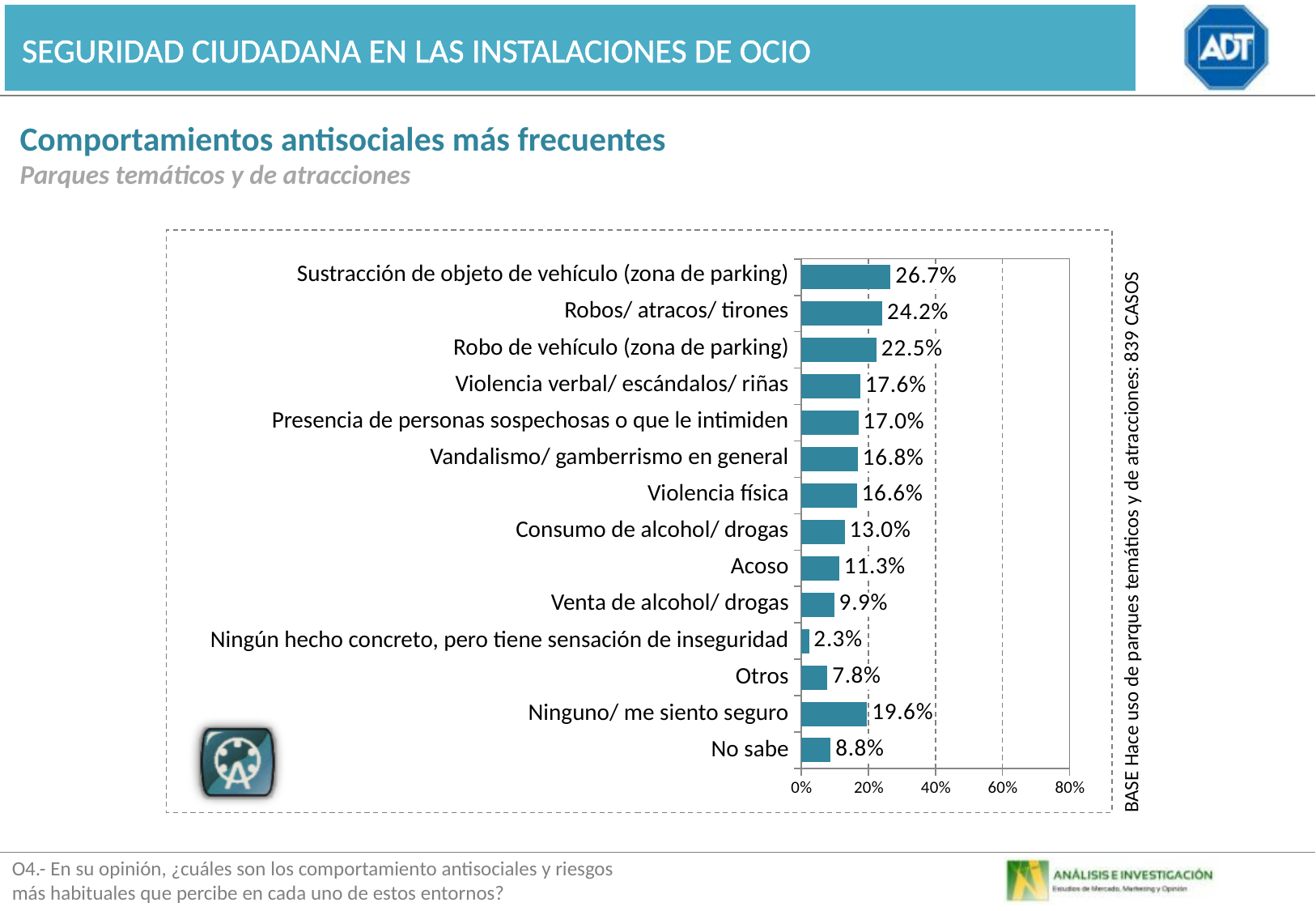
What is the base (number of cases) stated next to the chart? 839 casos What is the value for "Ninguno/ me siento seguro"? 19.6% How many categories are shown in the chart? 14 Which category has the lowest value? Ningún hecho concreto, pero tiene sensación de inseguridad What is the value for "Sustracción de objeto de vehículo (zona de parking)"? 26.7% What is the value for "Acoso"? 11.3% What is the value for "No sabe"? 8.8% Which category has the highest value? Sustracción de objeto de vehículo (zona de parking) What type of chart is shown on the slide? Bar chart What is the difference between the values for "Sustracción de objeto de vehículo (zona de parking)" and "Robos/ atracos/ tirones"? 2.5 percentage points Is the value for "Consumo de alcohol/ drogas" greater or less than 20%? less Which is larger, the value for "Acoso" or the value for "Otros"? Acoso